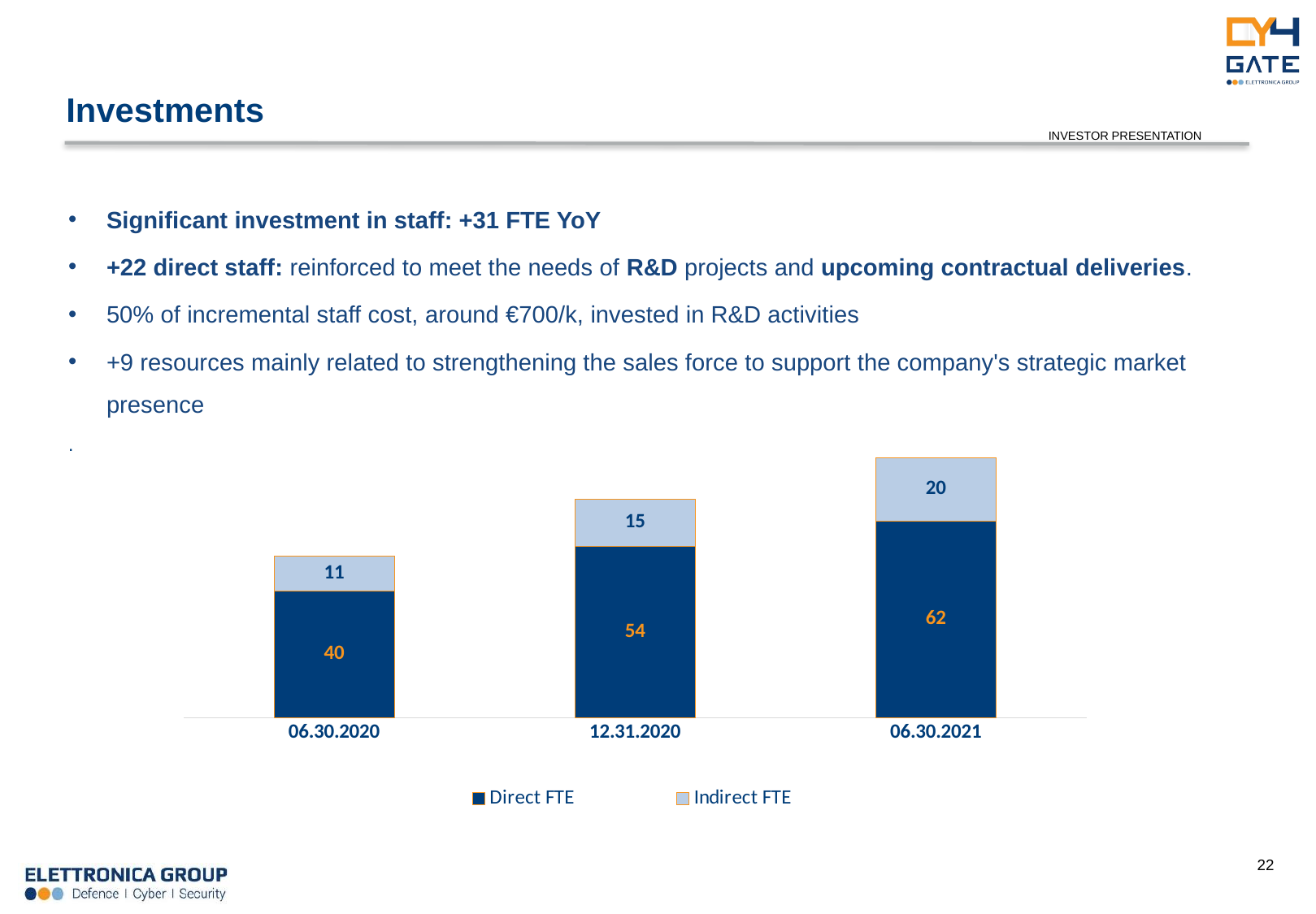
What is the difference between the Direct FTE values for 06.30.2021 and 06.30.2020? 22 What is the total FTE (Direct plus Indirect) for 06.30.2020? 51 Which date has the highest Direct FTE value? 06.30.2021 What kind of chart is shown on the slide? Stacked bar chart What is the Indirect FTE value for 12.31.2020? 15 What is the total FTE (Direct plus Indirect) for 06.30.2021? 82 How many dates are shown on the x axis of the chart? 3 What is the Direct FTE value for 06.30.2021? 62 Is the Indirect FTE value larger for 12.31.2020 or for 06.30.2021? 06.30.2021 How many series does the chart legend list? 2 Which date has the lowest Indirect FTE value? 06.30.2020 What is the Direct FTE value for 06.30.2020? 40